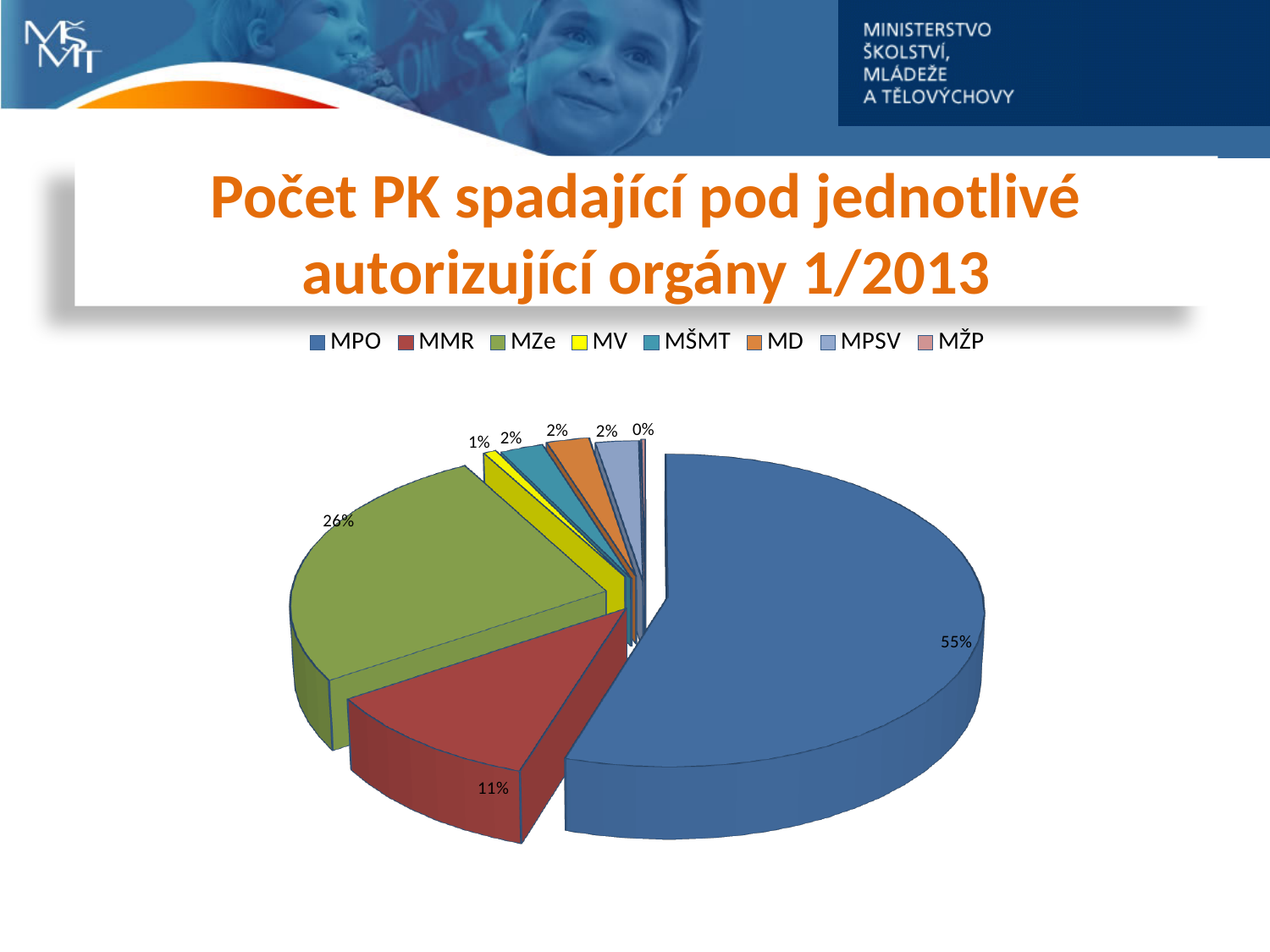
What share of the pie does MV hold? 1% Which category has the largest slice of the pie? MPO What is the title of the slide containing the chart? Počet PK spadající pod jednotlivé autorizující orgány 1/2013 Which category has the smallest slice of the pie? MŽP What share of the pie does MPO hold? 55% What share of the pie does MZe hold? 26% Which is larger, the MMR slice or the MZe slice? MZe What is the difference in percentage points between the MPO slice and the MZe slice? 29 What kind of chart is shown on the slide? pie chart How many categories does the legend list? 8